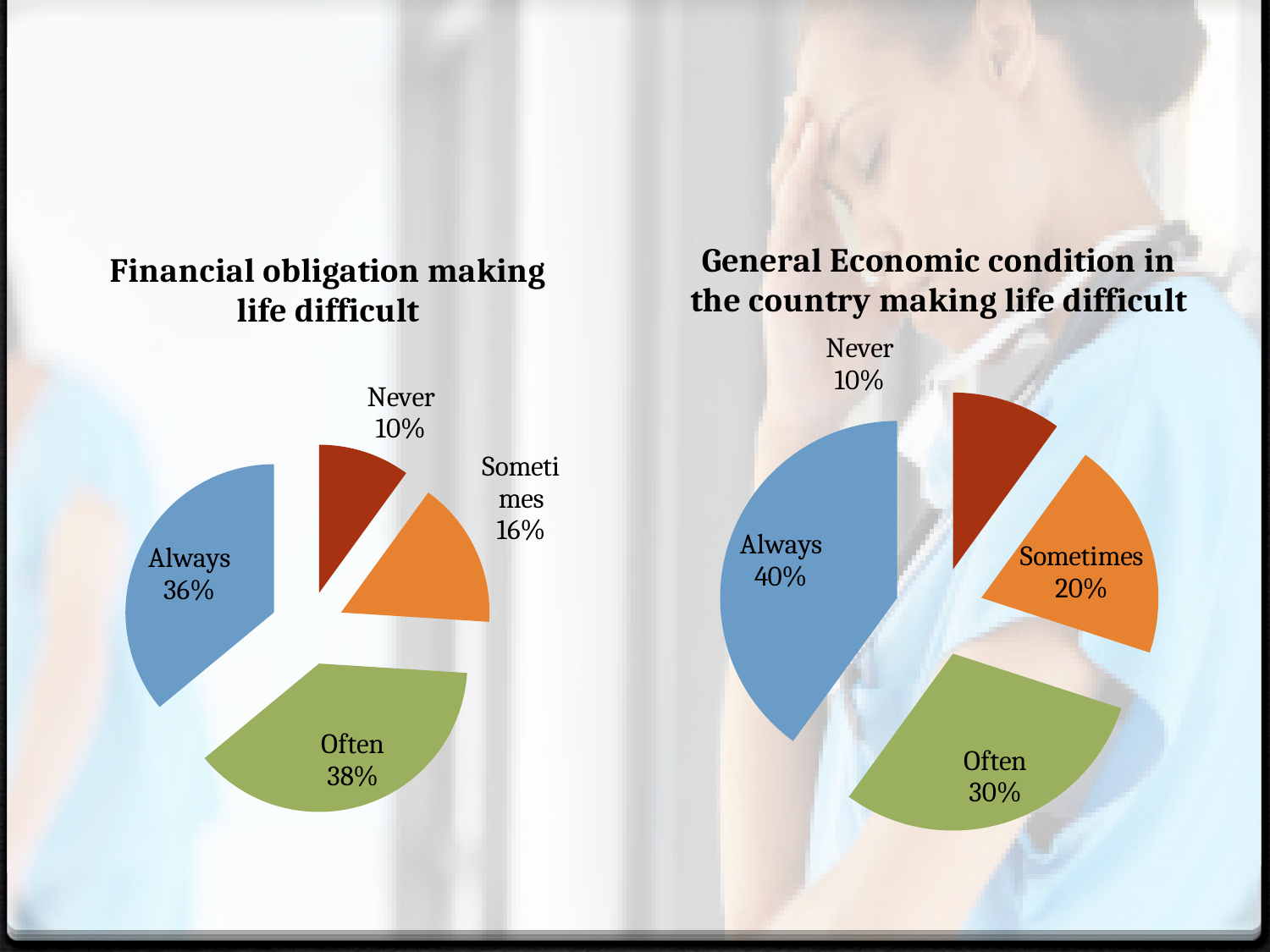
In the 'General Economic condition in the country making life difficult' chart, what percentage is shown for Always? 40% How many slices does the 'Financial obligation making life difficult' chart have? 4 In the 'General Economic condition in the country making life difficult' chart, what is the difference between the Always and Often shares? 10% In the 'Financial obligation making life difficult' chart, what colour is the Always slice? Blue What kind of chart is the 'General Economic condition in the country making life difficult' chart? Pie chart How many pie charts are on the slide? 2 In the 'General Economic condition in the country making life difficult' chart, which is larger: Often or Sometimes? Often In the 'Financial obligation making life difficult' chart, what percentage is shown for Never? 10% In the 'Financial obligation making life difficult' chart, what percentage is shown for Often? 38% In the 'Financial obligation making life difficult' chart, which category has the largest share? Often In the 'Financial obligation making life difficult' chart, what is the difference between the Always and Sometimes shares? 20% In the 'General Economic condition in the country making life difficult' chart, which category has the smallest share? Never